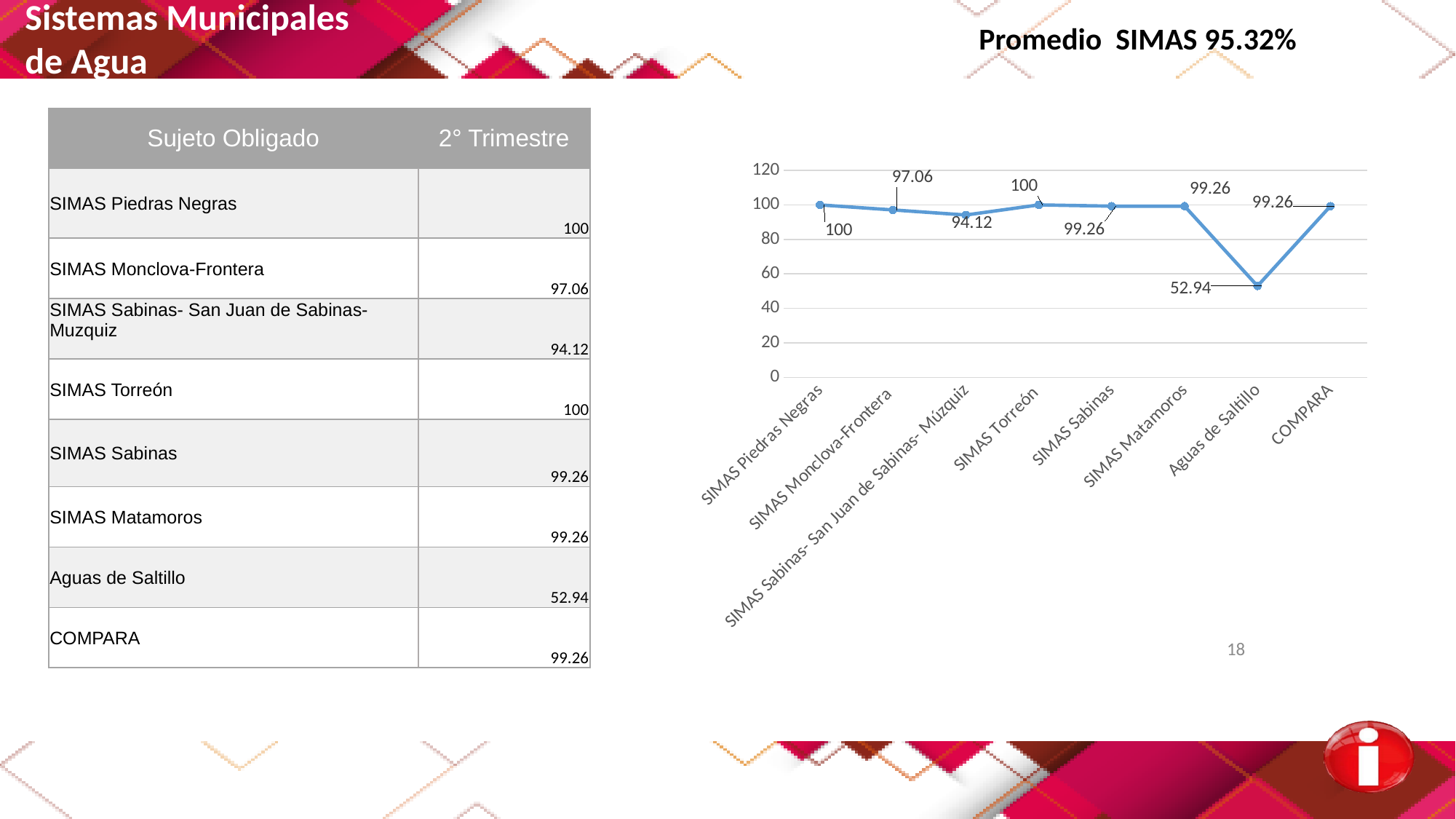
What is the highest value shown on the vertical axis? 120 Is the value for Aguas de Saltillo greater or less than 60? less What is the value for SIMAS Sabinas- San Juan de Sabinas- Múzquiz? 94.12 Which is larger, the value for SIMAS Monclova-Frontera or the value for SIMAS Sabinas- San Juan de Sabinas- Múzquiz? SIMAS Monclova-Frontera What is the value for Aguas de Saltillo? 52.94 What is the value for COMPARA? 99.26 What is the difference between the values for SIMAS Torreón and Aguas de Saltillo? 47.06 What is the difference between the values for SIMAS Piedras Negras and SIMAS Monclova-Frontera? 2.94 What type of chart is shown on the slide? line chart Which category has the lowest value? Aguas de Saltillo How many categories are plotted on the x axis? 8 What is the value for SIMAS Monclova-Frontera? 97.06